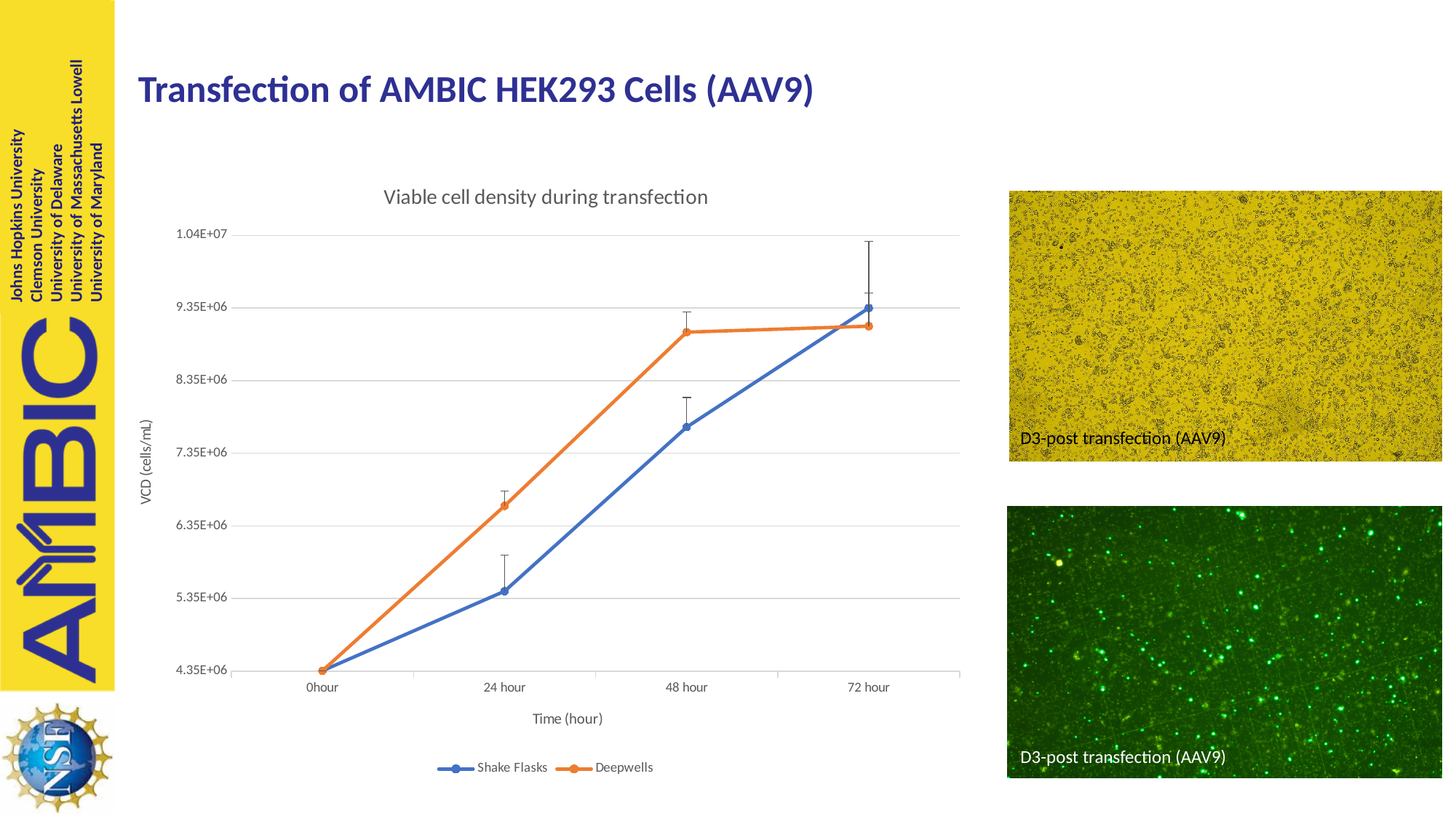
How many series does the chart legend list? 2 Is the value for Shake Flasks at 24 hour greater or less than 6.35E+06? less What is the title of the chart? Viable cell density during transfection At 48 hour, which series has the higher viable cell density, Shake Flasks or Deepwells? Deepwells At 24 hour, which series has the higher viable cell density, Shake Flasks or Deepwells? Deepwells Is the value for Shake Flasks at 48 hour greater or less than 7.35E+06? greater How many time points are plotted along the x axis? 4 What kind of chart is shown on the slide? line chart What is the label of the y axis? VCD (cells/mL) Is the value for Deepwells at 48 hour greater or less than 8.35E+06? greater Does the viable cell density for Shake Flasks rise or fall from 0hour to 72 hour? rise